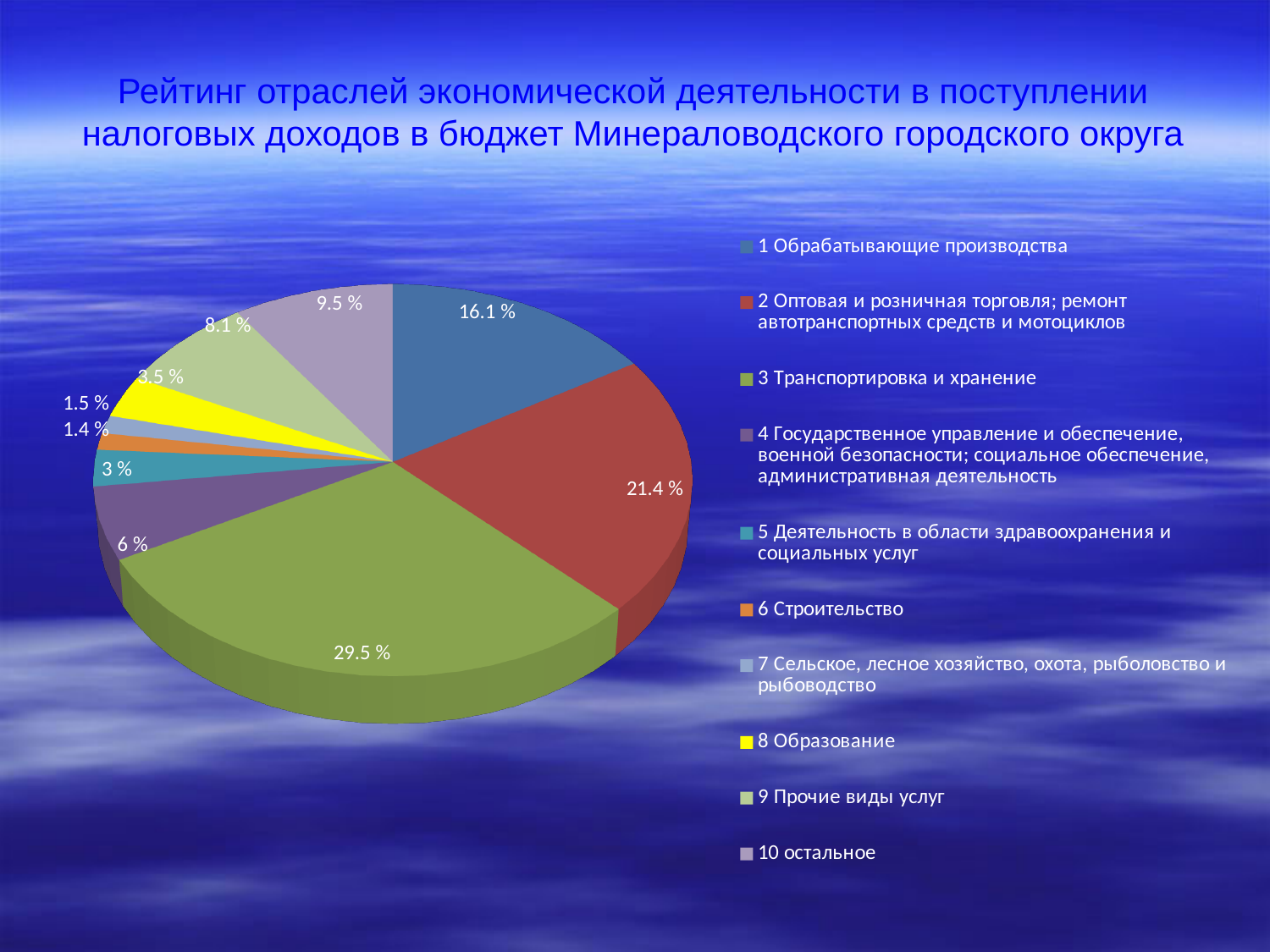
What share of the pie does "10 остальное" have? 9.5 % How many slices does the pie chart have? 10 Which category has the smallest share of the pie? 6 Строительство Which has a larger share: "9 Прочие виды услуг" or "4 Государственное управление и обеспечение, военной безопасности; социальное обеспечение, административная деятельность"? 9 Прочие виды услуг What share of the pie does "1 Обрабатывающие производства" have? 16.1 % What is the difference in percentage points between the shares of "3 Транспортировка и хранение" and "2 Оптовая и розничная торговля; ремонт автотранспортных средств и мотоциклов"? 8.1 Which category has the largest share of the pie? 3 Транспортировка и хранение What share of the pie does "8 Образование" have? 3.5 % What colour is the slice for "8 Образование"? yellow What share of the pie does "3 Транспортировка и хранение" have? 29.5 % What share of the pie does "2 Оптовая и розничная торговля; ремонт автотранспортных средств и мотоциклов" have? 21.4 % What type of chart is shown on the slide? pie chart